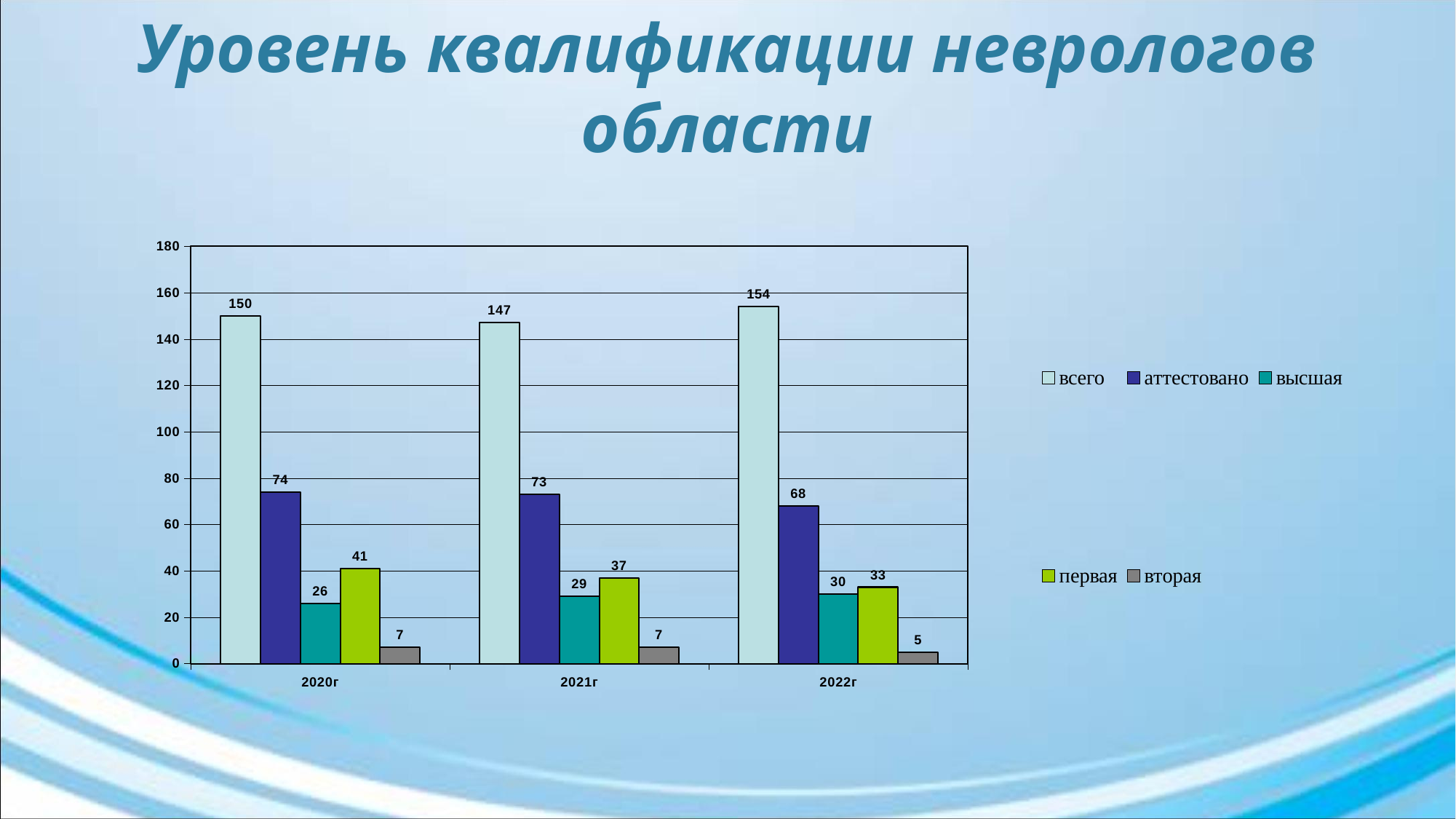
What is the value for вторая in 2022г? 5 What is the value for всего in 2022г? 154 What is the value for аттестовано in 2020г? 74 What kind of chart is shown on the slide? Bar chart In which year is the всего value highest? 2022г What is the value for высшая in 2021г? 29 How many year categories are shown on the x axis? 3 How many series does the legend list? 5 Which is larger, первая in 2020г or первая in 2022г? первая in 2020г Does the аттестовано value rise or fall from 2020г to 2022г? Fall In which year is the аттестовано value lowest? 2022г What is the difference between the всего values for 2022г and 2021г? 7